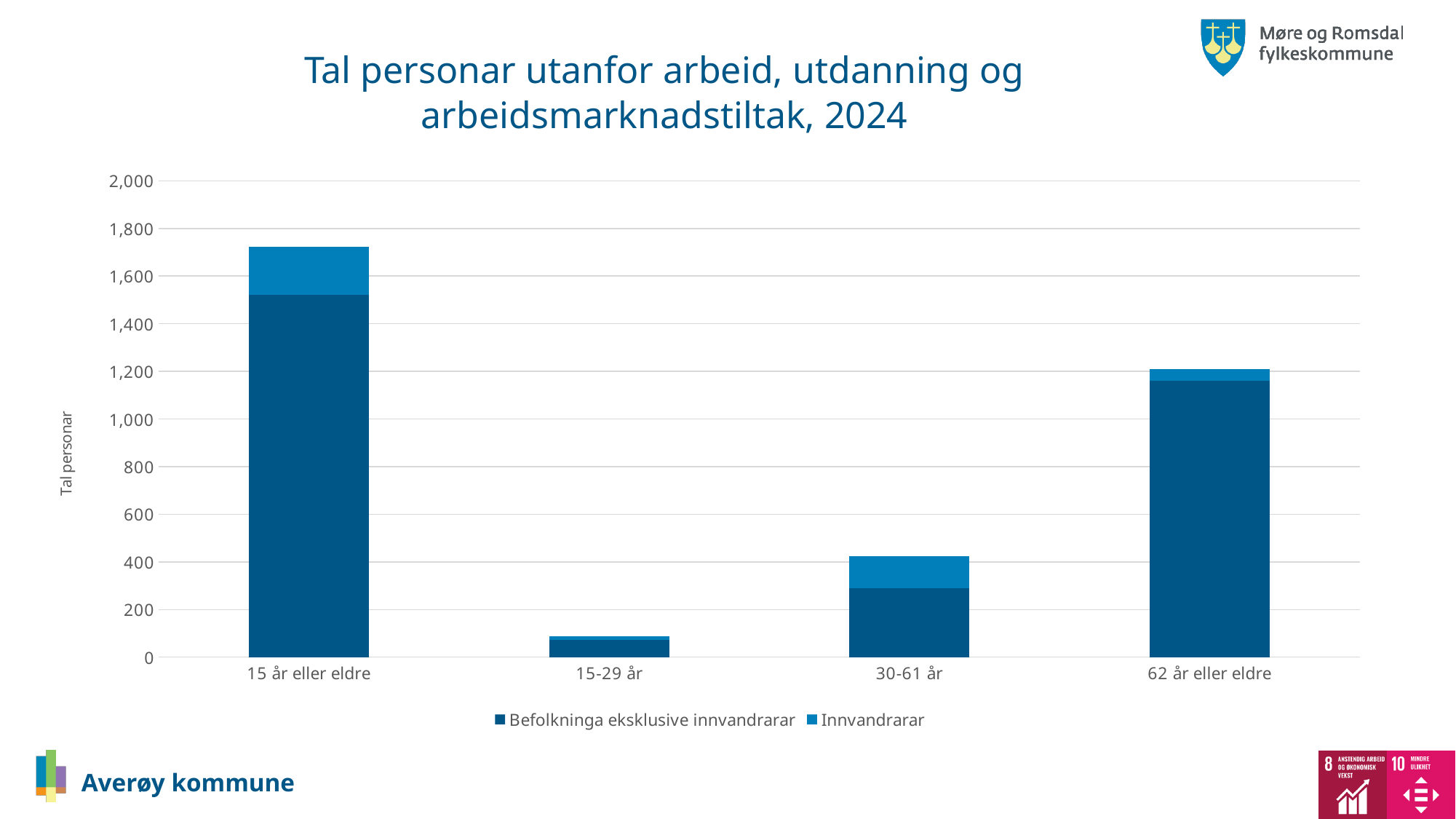
Which age category has the tallest stacked bar? 15 år eller eldre Is the total stacked value for 30-61 år greater or less than 600? less Which age category has the shortest stacked bar? 15-29 år Is the total stacked value for 15-29 år greater or less than 200? less Which has a taller stacked bar, 30-61 år or 62 år eller eldre? 62 år eller eldre Is the total stacked value for 15 år eller eldre greater or less than 1,600? greater What is the label on the y axis? Tal personar How many age categories are shown on the x axis? 4 What is the title of the chart? Tal personar utanfor arbeid, utdanning og arbeidsmarknadstiltak, 2024 How many series does the legend list? 2 What kind of chart is shown on the slide? bar chart